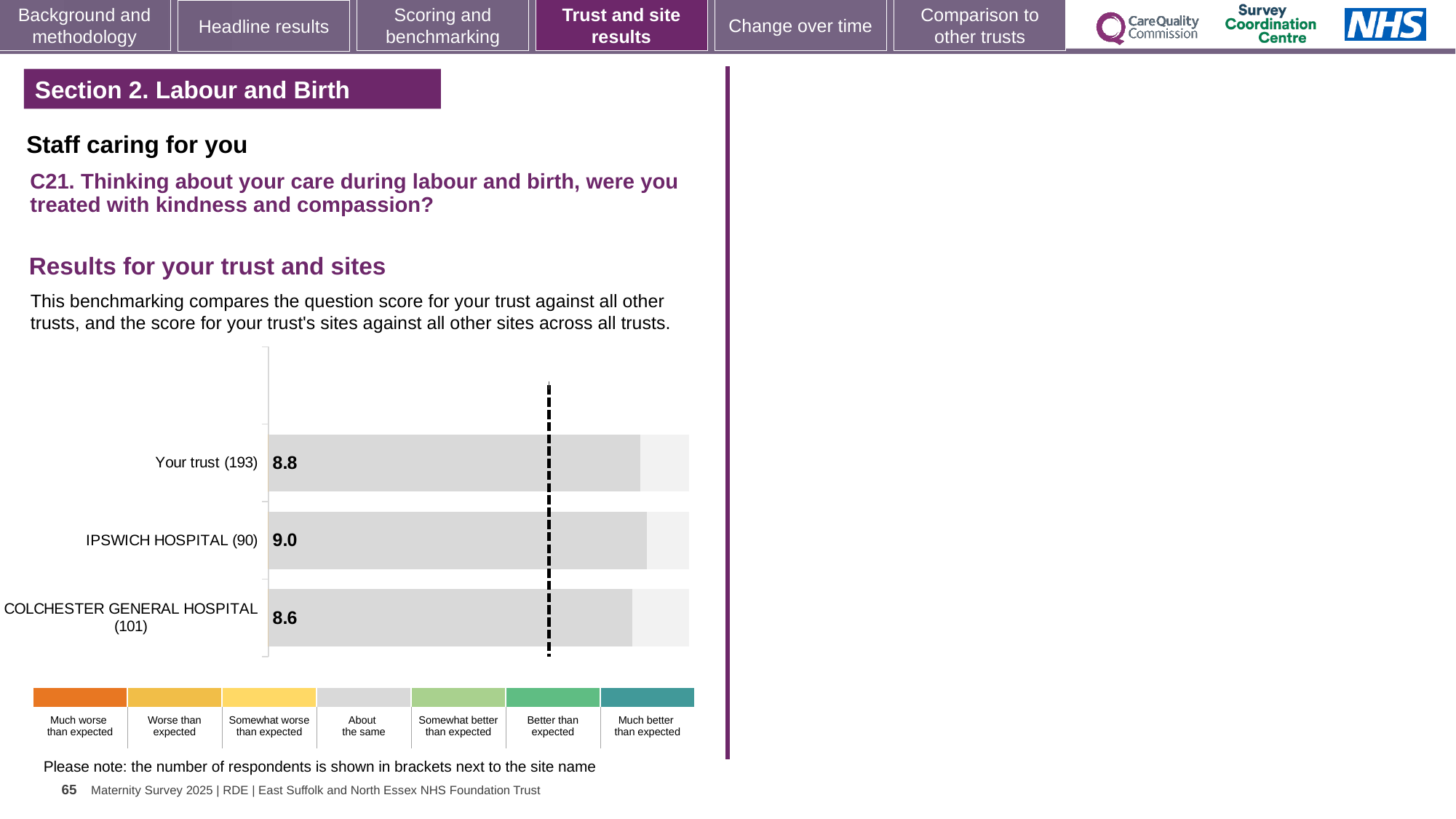
What is the difference between the scores for IPSWICH HOSPITAL and Your trust? 0.2 How many bars are shown in the chart? 3 Which has a higher score, Your trust or COLCHESTER GENERAL HOSPITAL? Your trust Which site or trust has the highest score? IPSWICH HOSPITAL What is the score for IPSWICH HOSPITAL? 9.0 What kind of chart is shown on the slide? Bar chart What is the score for COLCHESTER GENERAL HOSPITAL? 8.6 What is the difference between the scores for IPSWICH HOSPITAL and COLCHESTER GENERAL HOSPITAL? 0.4 How many respondents are shown in brackets for IPSWICH HOSPITAL? 90 Which site or trust has the lowest score? COLCHESTER GENERAL HOSPITAL How many respondents are shown in brackets for Your trust? 193 What is the score for Your trust? 8.8